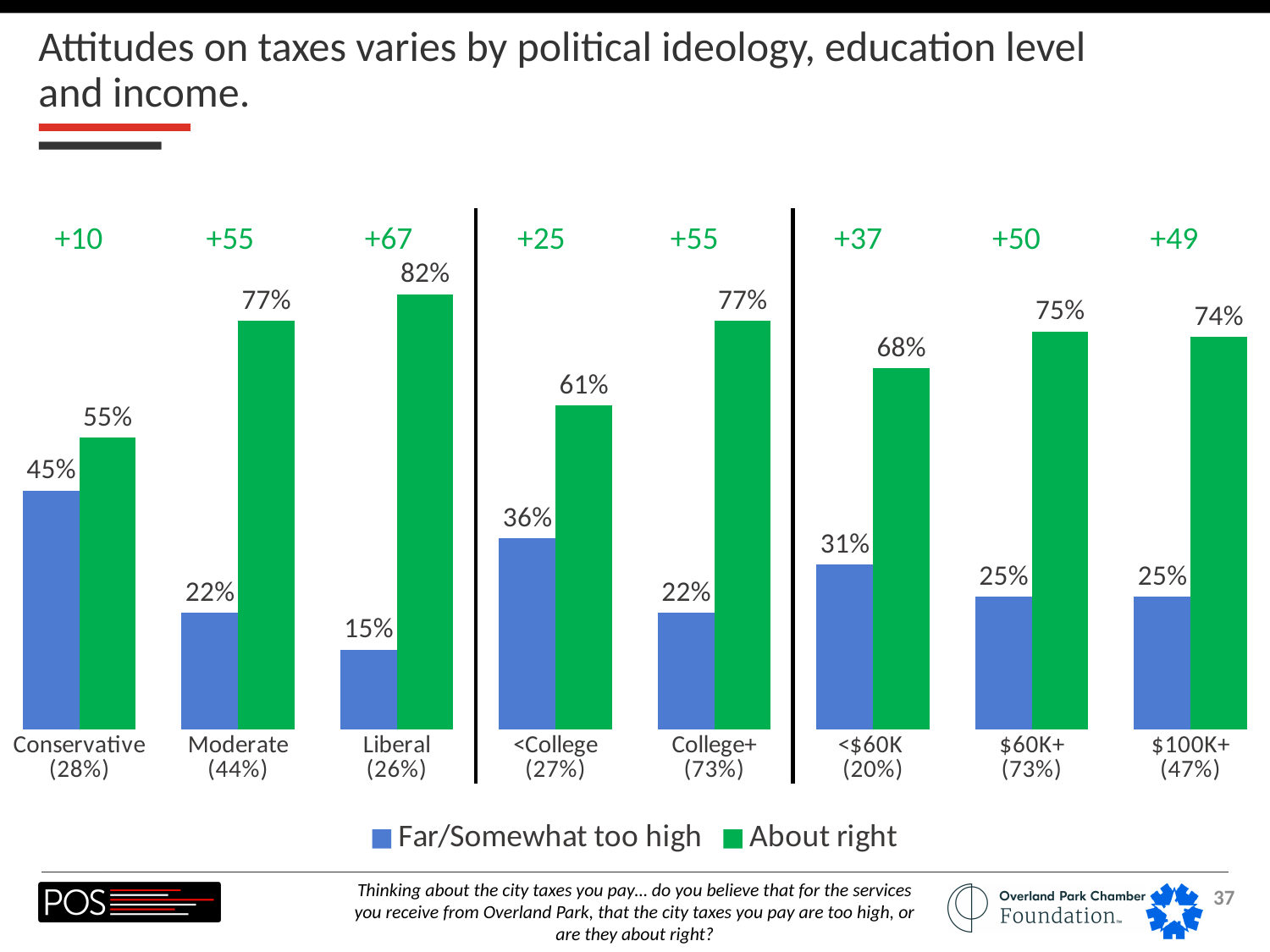
Which is larger: the 'Far/Somewhat too high' value for Conservatives or for Moderates? Conservative What percentage of Liberals say city taxes are about right? 82% How many categories are shown on the x axis of the chart? 8 What is the difference between the 'About right' and 'Far/Somewhat too high' values for the <College group? 25 What is the net figure shown above the $60K+ bars? +50 Which category has the lowest 'Far/Somewhat too high' value? Liberal What kind of chart is shown on the slide? Bar chart How many series does the legend list? 2 What percentage of Conservatives say city taxes are far/somewhat too high? 45% What is the 'About right' value for the <$60K income group? 68% Which series is shown in green in the legend? About right Which category has the highest 'About right' value? Liberal